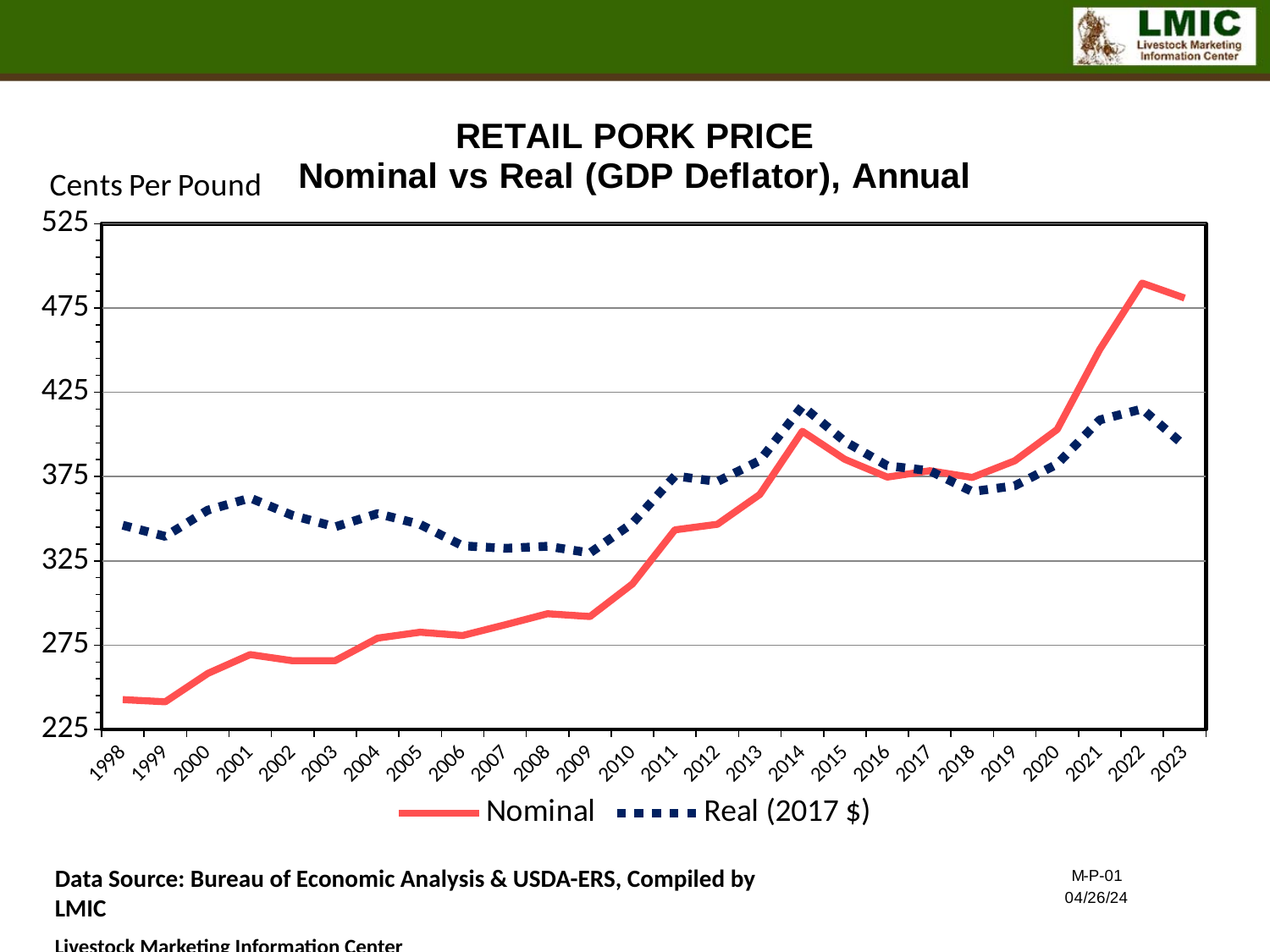
Is the Real (2017 $) value for 2001 greater or less than 375? less Is the Nominal value for 2022 greater or less than 475? greater What type of chart is shown on the slide? Line chart How many series does the legend list? 2 In 2022, which series has the higher value, Nominal or Real (2017 $)? Nominal Does the Nominal series generally rise or fall from 1998 to 2023? Rise Is the Nominal value for 1998 greater or less than 275? less In which year does the Nominal series reach its highest value? 2022 How many years are plotted along the x axis? 26 What unit is shown on the y axis label? Cents Per Pound In 1998, which series has the higher value, Nominal or Real (2017 $)? Real (2017 $)